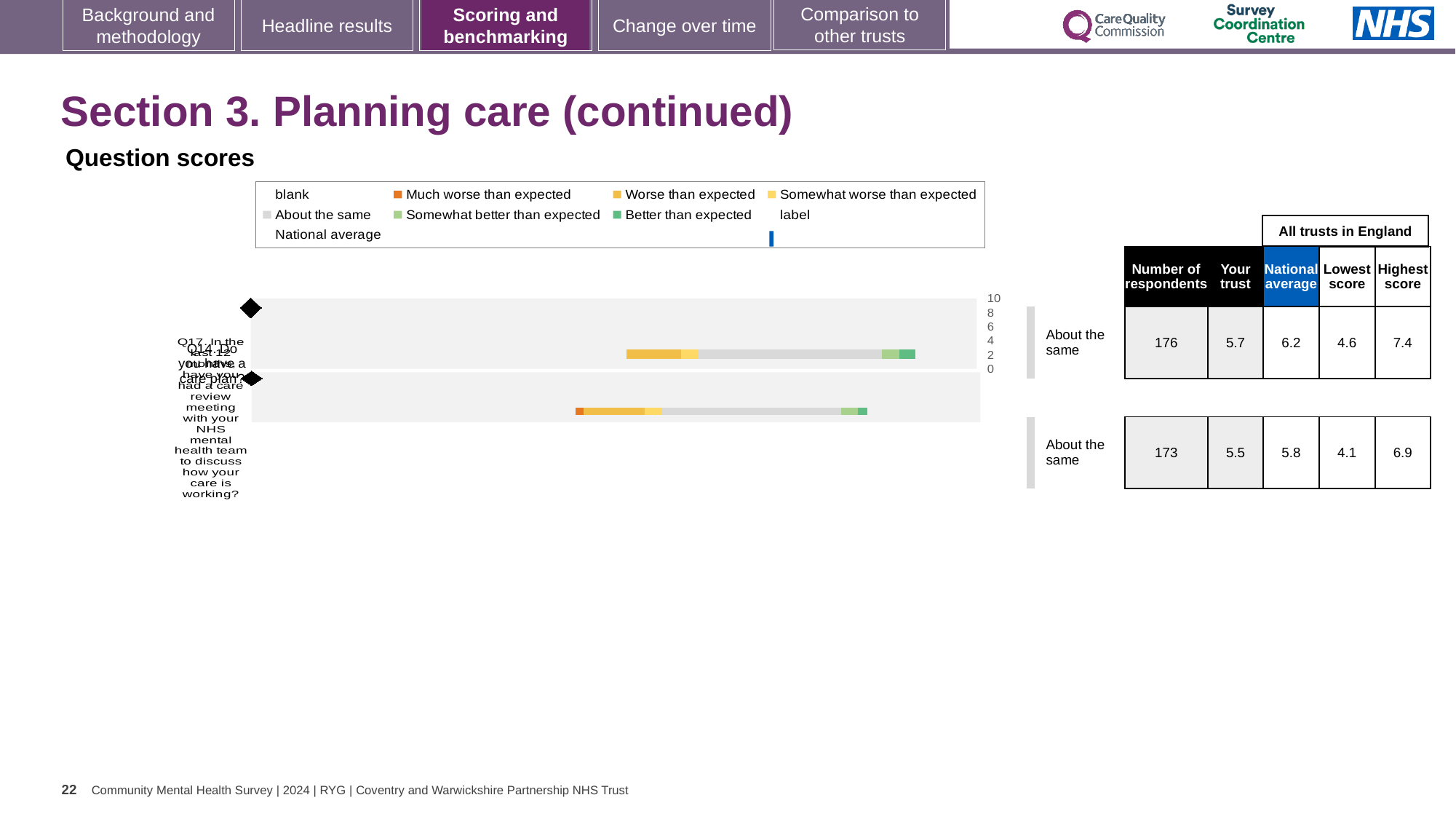
What benchmark category is shown next to both bars? About the same In the table, what is the national average for the first row (Q14)? 6.2 What is the difference between the national average and the 'Your trust' score for the first row (Q14)? 0.5 Which row has the larger 'Your trust' score, the first row (Q14) or the second row (Q17)? the first row (Q14) According to the legend, what does the blue marker represent? National average What kind of chart is shown on the slide? bar chart In the table, what is the highest score for the second row (Q17)? 6.9 In the table, what is the 'Your trust' score for the first row (Q14)? 5.7 In the table, what is the lowest score for the second row (Q17)? 4.1 What is the difference between the highest and lowest score for the second row (Q17)? 2.8 How many questions (bars) are plotted in the chart? 2 In the table, what is the number of respondents for the first row (Q14)? 176